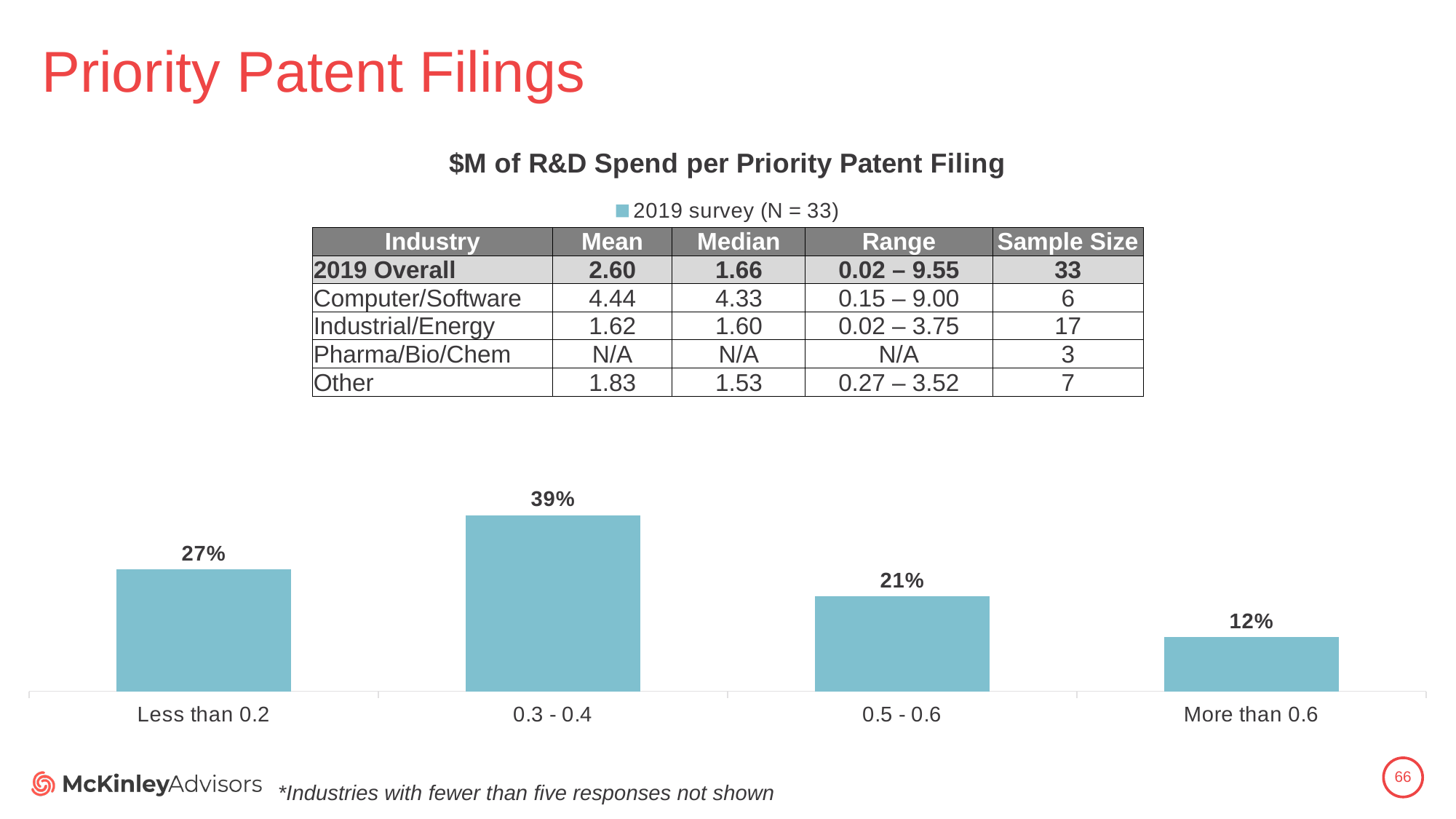
What is the difference between the values for "0.5 - 0.6" and "More than 0.6"? 9% What is the difference between the values for "0.3 - 0.4" and "Less than 0.2"? 12% What is the value for the "0.3 - 0.4" category in the bar chart? 39% How many categories are shown in the bar chart? 4 What is the value for the "0.5 - 0.6" category in the bar chart? 21% Which category has the highest value in the bar chart? 0.3 - 0.4 What is the value for the "Less than 0.2" category in the bar chart? 27% What is the value for the "More than 0.6" category in the bar chart? 12% Which category has the lowest value in the bar chart? More than 0.6 Which is larger, the value for "Less than 0.2" or the value for "0.5 - 0.6"? Less than 0.2 What kind of chart is shown on the slide? Bar chart What is the title of the chart? $M of R&D Spend per Priority Patent Filing